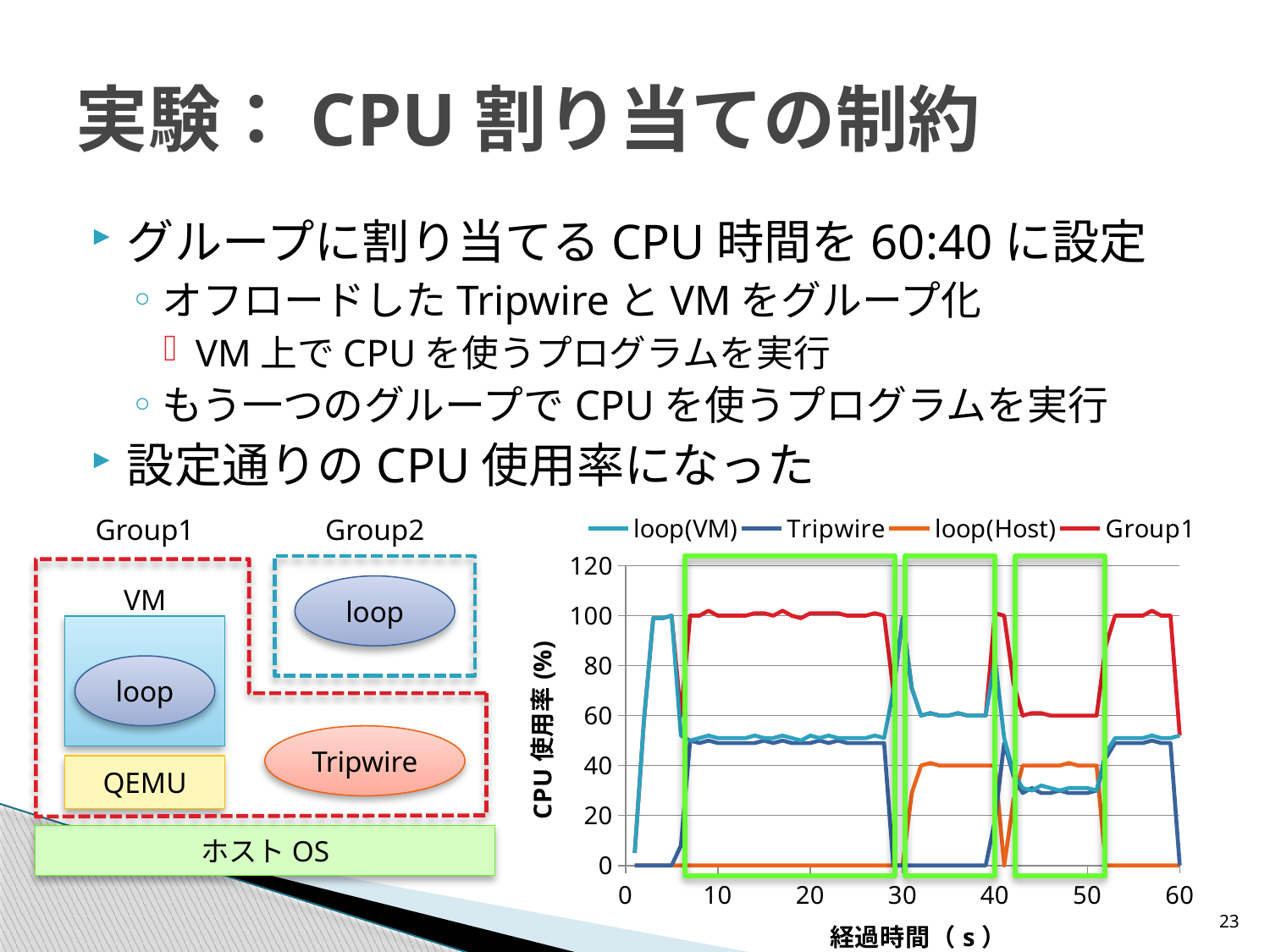
Is the value of loop(Host) at 20 s greater or less than 20? less Is the value of loop(Host) at 35 s greater or less than 20? greater Is the value of Tripwire at 20 s greater or less than 20? greater What is the title of the chart's vertical axis? CPU 使用率 (%) At 35 s, which series has the larger value, Group1 or loop(Host)? Group1 Does the loop(VM) series rise or fall between 0 s and 3 s? rise How many series does the chart legend list? 4 What are the series names listed in the chart legend? loop(VM), Tripwire, loop(Host), Group1 At 20 s, which series has the larger value, loop(VM) or loop(Host)? loop(VM) What kind of chart is shown on the slide? line chart